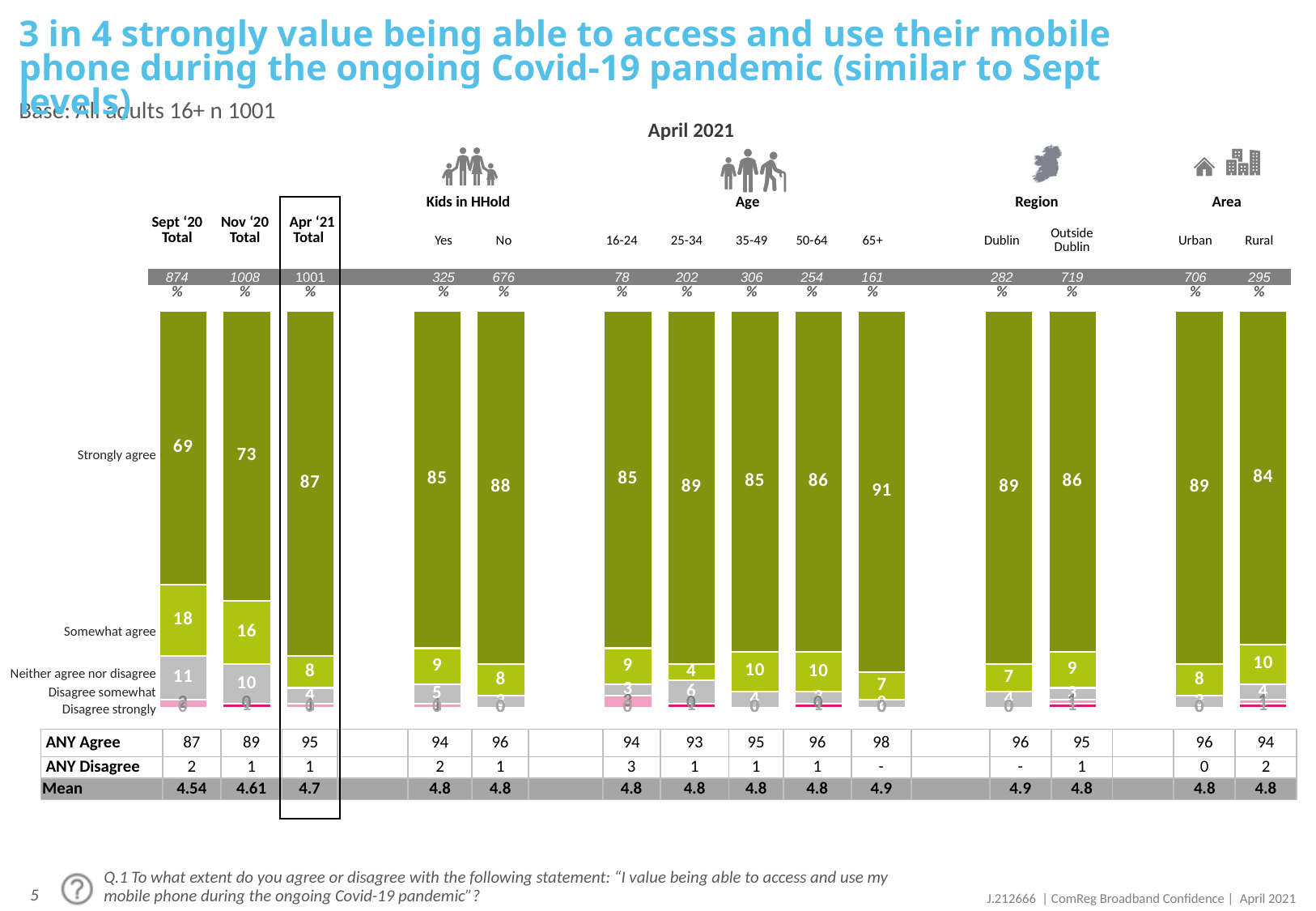
Among the Age groups, which has the highest Strongly agree value? 65+ What is the ANY Agree figure for the 65+ age group? 98 How many bars are plotted on the chart? 14 Which has the larger Strongly agree value, Urban or Rural? Urban Does the Strongly agree value rise or fall across Sept '20, Nov '20 and Apr '21? Rises What is the base size shown for the Kids in HHold 'Yes' group? 325 What percentage of the Apr '21 Total strongly agree? 87 By how many percentage points did Strongly agree rise from Sept '20 Total to Apr '21 Total? 18 What kind of chart is shown on the slide? Stacked bar chart Which bar has the lowest Strongly agree value on the chart? Sept '20 Total What is the Somewhat agree value for the Sept '20 Total bar? 18 What is the Mean score for the Apr '21 Total? 4.7